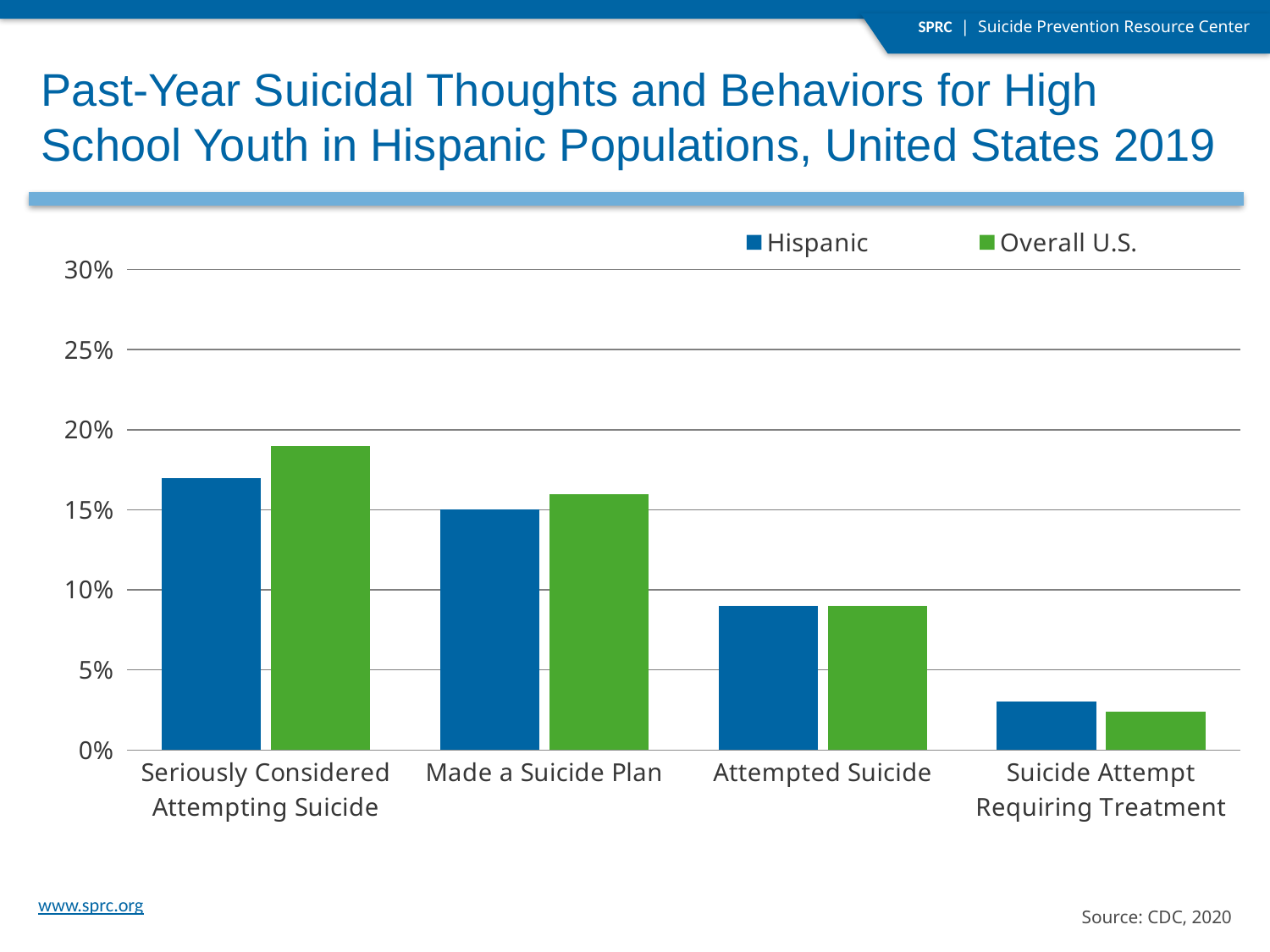
Is the Hispanic value for Seriously Considered Attempting Suicide greater or less than 15%? greater Do the Hispanic values rise or fall moving from left to right across the categories? fall Is the Overall U.S. value for Seriously Considered Attempting Suicide greater or less than 20%? less Which category has the lowest value for the Hispanic series? Suicide Attempt Requiring Treatment Which category has the highest value for the Overall U.S. series? Seriously Considered Attempting Suicide How many categories are shown on the x axis? 4 What colour represents the Hispanic series in the legend? blue For Made a Suicide Plan, which series has the larger value, Hispanic or Overall U.S.? Overall U.S. For Seriously Considered Attempting Suicide, which series has the larger value, Hispanic or Overall U.S.? Overall U.S. Is the Hispanic value for Attempted Suicide greater or less than 10%? less How many series does the legend list? 2 What kind of chart is shown on the slide? bar chart